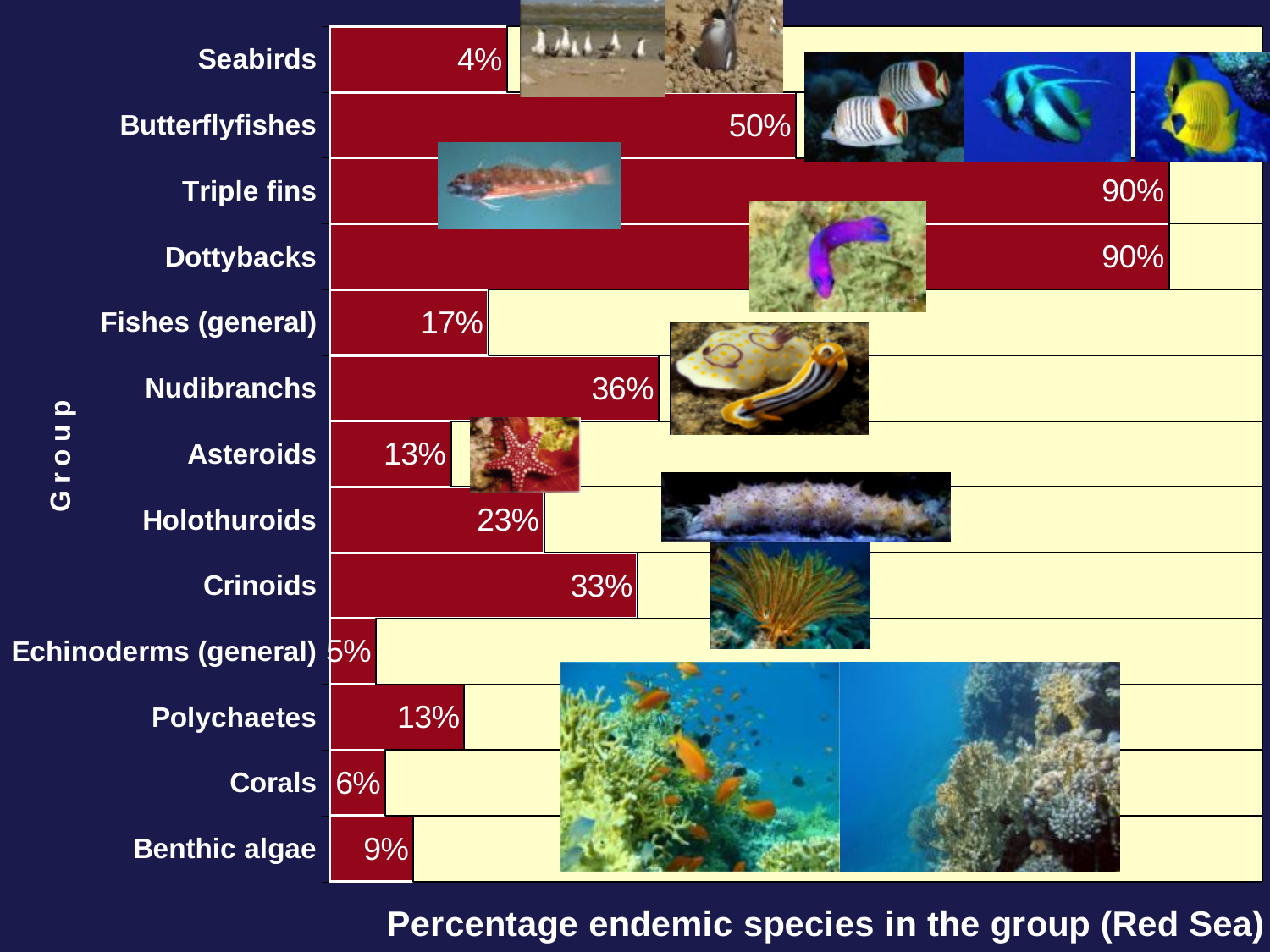
What is the difference between the percentage for Holothuroids and the percentage for Asteroids? 10% What is the percentage of endemic species for Butterflyfishes? 50% Which group has the lowest percentage of endemic species? Seabirds What is the difference between the percentage for Butterflyfishes and the percentage for Fishes (general)? 33% What is the percentage of endemic species for Nudibranchs? 36% What is the percentage of endemic species for Crinoids? 33% What kind of chart is shown on the slide? Bar chart Which has a higher percentage of endemic species, Nudibranchs or Crinoids? Nudibranchs How many groups are shown in the chart? 13 Which two groups share the highest percentage of endemic species? Triple fins and Dottybacks What is the percentage of endemic species for Corals? 6% Which has a higher percentage of endemic species, Benthic algae or Echinoderms (general)? Benthic algae